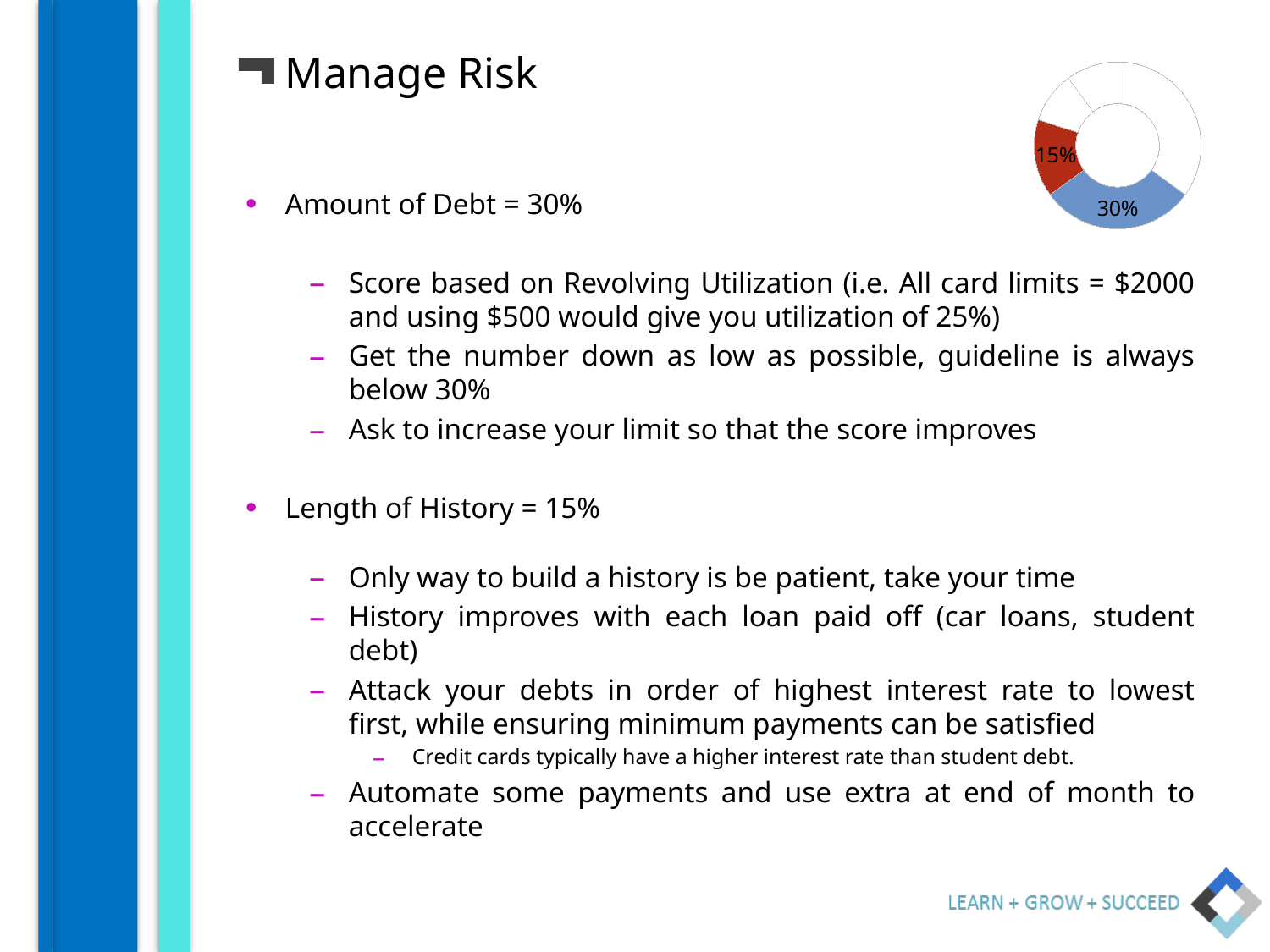
What colour is the slice labelled 30% in the doughnut chart? blue What is the difference between the two labelled slices in the doughnut chart? 15 percentage points What is the smallest labelled value shown in the doughnut chart? 15% What is the largest labelled value shown in the doughnut chart? 30% What share of the doughnut chart does the blue slice represent? 30% What colour is the slice labelled 15% in the doughnut chart? red Is the value of the blue slice in the doughnut chart greater or less than 25%? greater What do the two labelled slices of the doughnut chart add up to? 45% What kind of chart is shown in the top right of the slide? doughnut chart What value is printed on the red slice of the doughnut chart? 15% What value is printed on the blue slice of the doughnut chart? 30% Which of the two labelled slices in the doughnut chart is larger, the blue one or the red one? the blue one (30%)